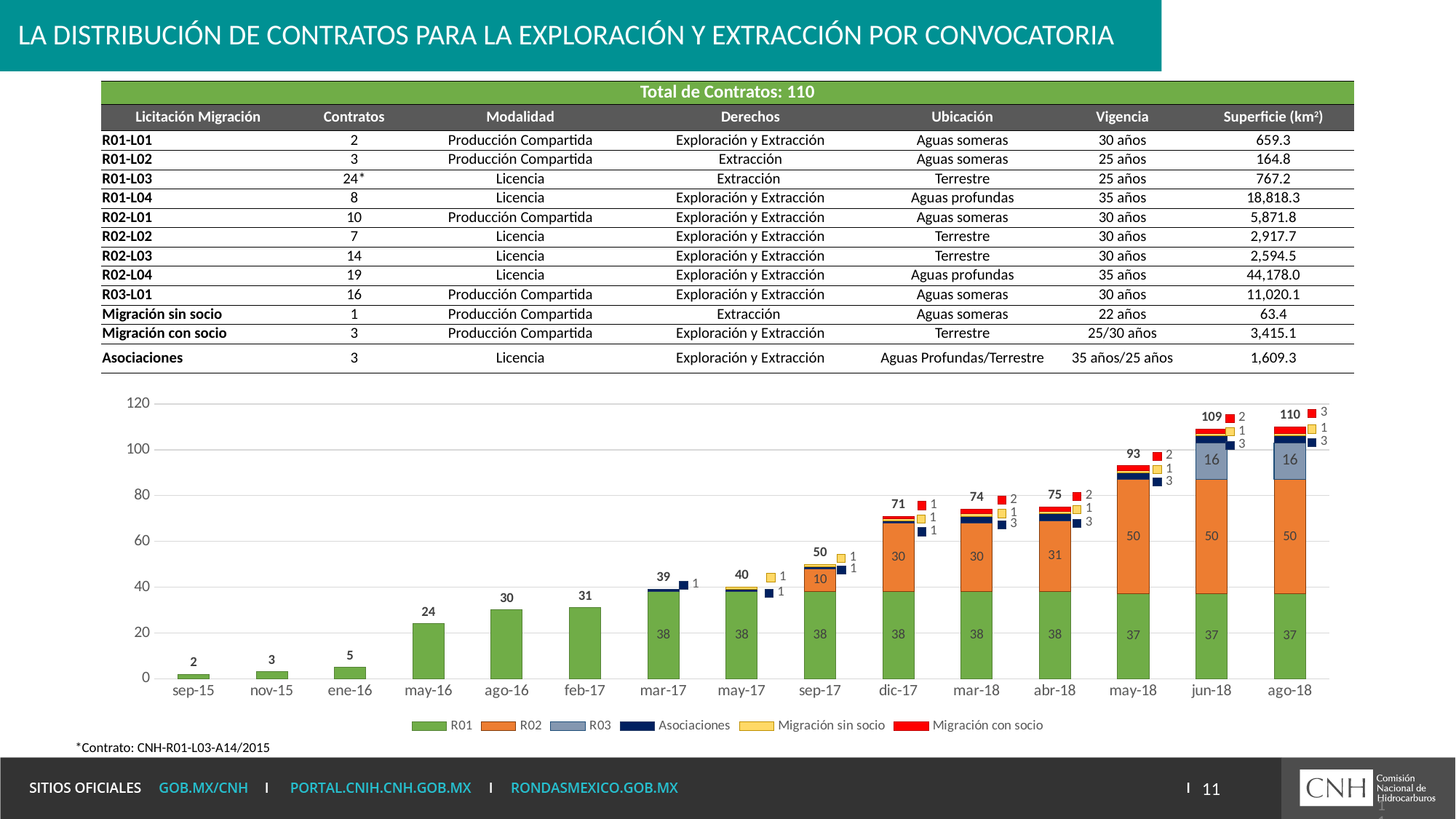
Which has a larger total, feb-17 or sep-17? sep-17 What is the R01 value in the ago-18 bar? 37 Which date has the lowest total of contracts? sep-15 How many dates are shown on the x axis of the chart? 15 What is the difference between the totals for may-18 and abr-18? 18 What is the total number of contracts shown above the bar for may-16? 24 Do the total contract values rise or fall from sep-15 to ago-18? rise Which date has the highest total of contracts? ago-18 Is the total for may-18 greater or less than 80? greater How many series does the legend list? 6 What is the R03 value in the jun-18 bar? 16 What is the R02 value in the dic-17 bar? 30